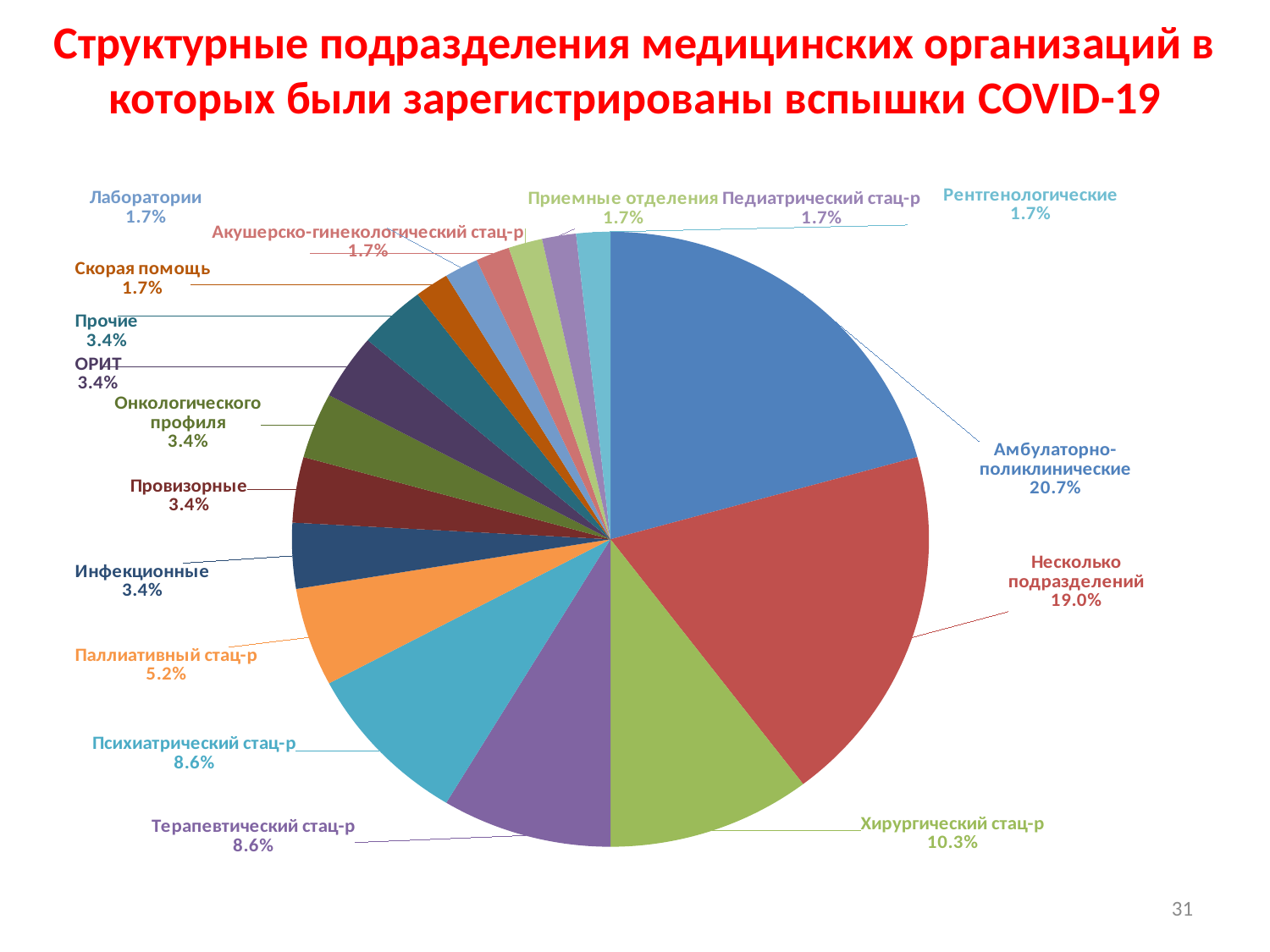
What share of the pie does Амбулаторно-поликлинические account for? 20.7% What is the value shown for Скорая помощь? 1.7% What is the title of the slide? Структурные подразделения медицинских организаций в которых были зарегистрированы вспышки COVID-19 What is the value shown for Несколько подразделений? 19.0% How many categories (slices) does the pie chart have? 17 Which is larger: the share for Хирургический стац-р or the share for Психиатрический стац-р? Хирургический стац-р What type of chart is shown on the slide? pie chart What is the difference between the shares of Амбулаторно-поликлинические and Несколько подразделений? 1.7% What is the value shown for Хирургический стац-р? 10.3% What is the value shown for Паллиативный стац-р? 5.2% Which category has the largest share of the pie? Амбулаторно-поликлинические What is the value shown for Инфекционные? 3.4%